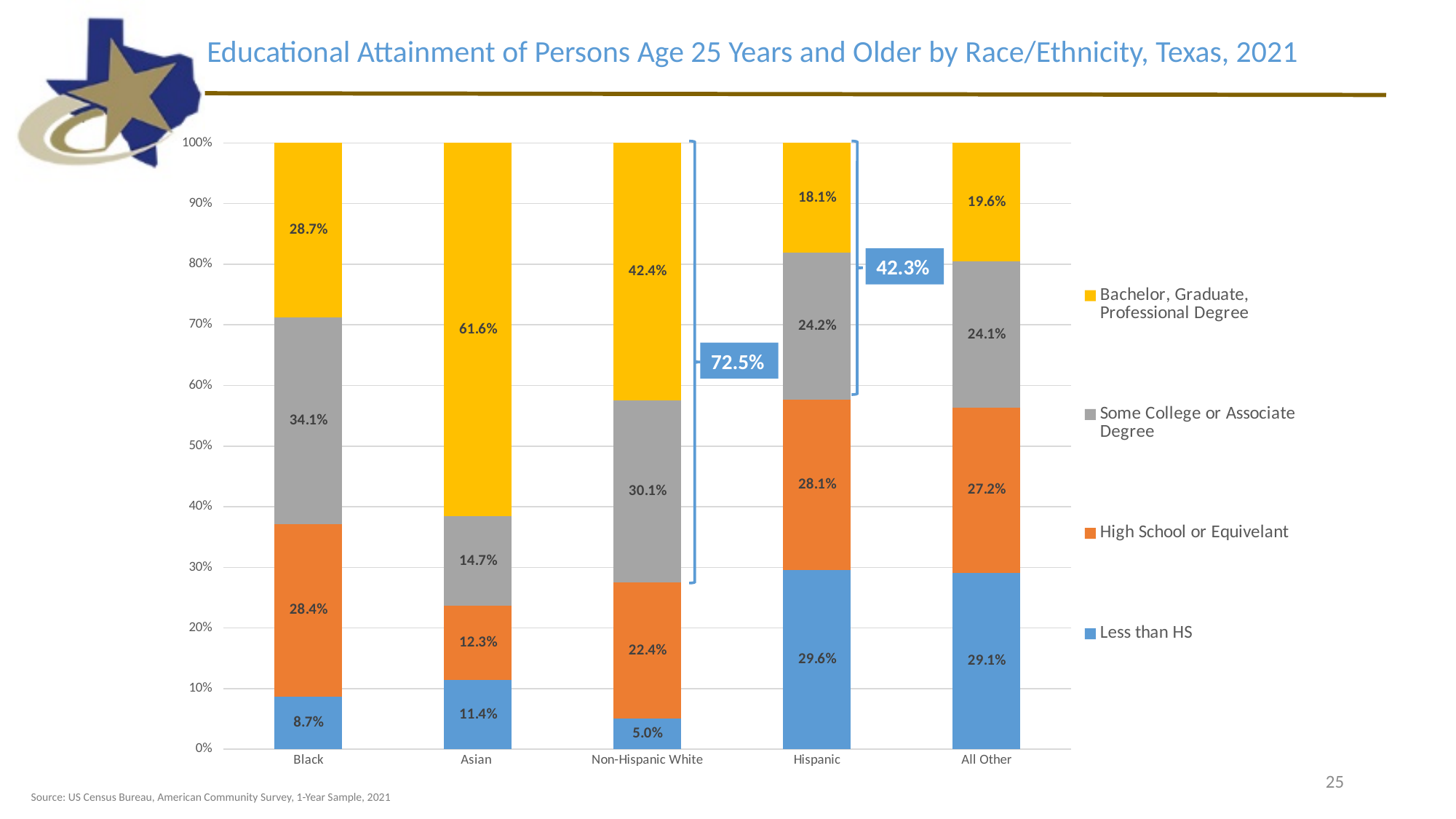
What kind of chart is shown on the slide? Stacked bar chart What is the difference between the Bachelor, Graduate, Professional Degree shares for Asian and Black persons? 32.9% What is the Some College or Associate Degree share for Black persons? 34.1% How many series does the legend list? 4 Which colour represents the Less than HS series? Blue Which is larger: the Less than HS share for Hispanic persons or for All Other persons? Hispanic Which race/ethnicity group has the highest share with a Bachelor, Graduate, or Professional Degree? Asian What is the High School or Equivelant share for Non-Hispanic White persons? 22.4% Which race/ethnicity group has the lowest Less than HS share? Non-Hispanic White What percentage of Asian persons age 25 and older have a Bachelor, Graduate, or Professional Degree? 61.6% How many race/ethnicity categories are shown on the x axis? 5 What is the Less than HS share for Hispanic persons? 29.6%